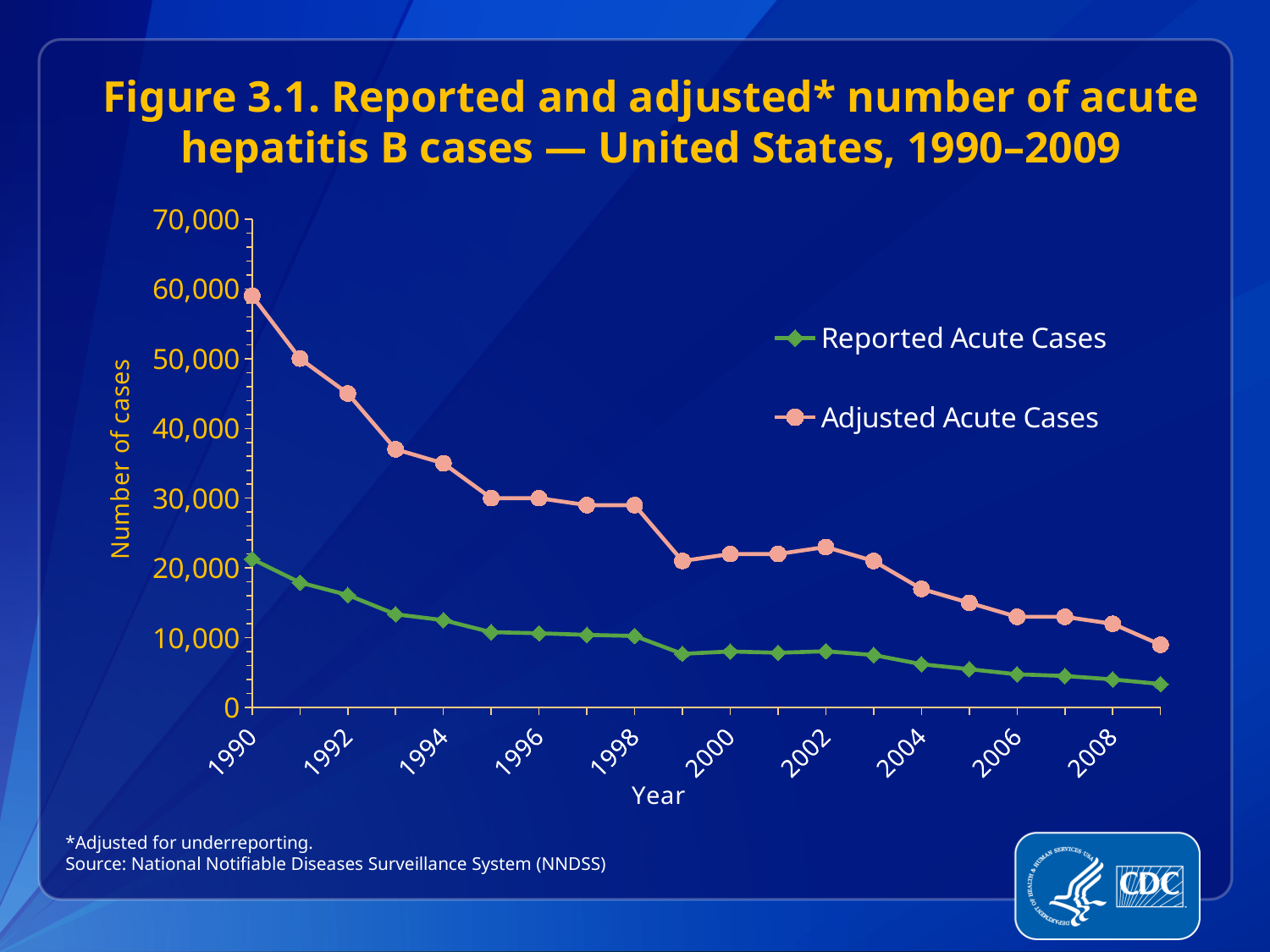
Is the value for Adjusted Acute Cases in 2009 greater or less than 20,000? less Do the Adjusted Acute Cases rise or fall from 1990 to 2009? fall Is the value for Adjusted Acute Cases in 1993 greater or less than 30,000? greater In 2000, which series has the higher value, Reported Acute Cases or Adjusted Acute Cases? Adjusted Acute Cases Is the value for Reported Acute Cases in 2009 greater or less than 10,000? less What kind of chart is shown on the slide? line chart In which year are the Adjusted Acute Cases highest? 1990 How many series does the legend list? 2 What are the two series named in the legend? Reported Acute Cases and Adjusted Acute Cases What is the title of the vertical axis? Number of cases